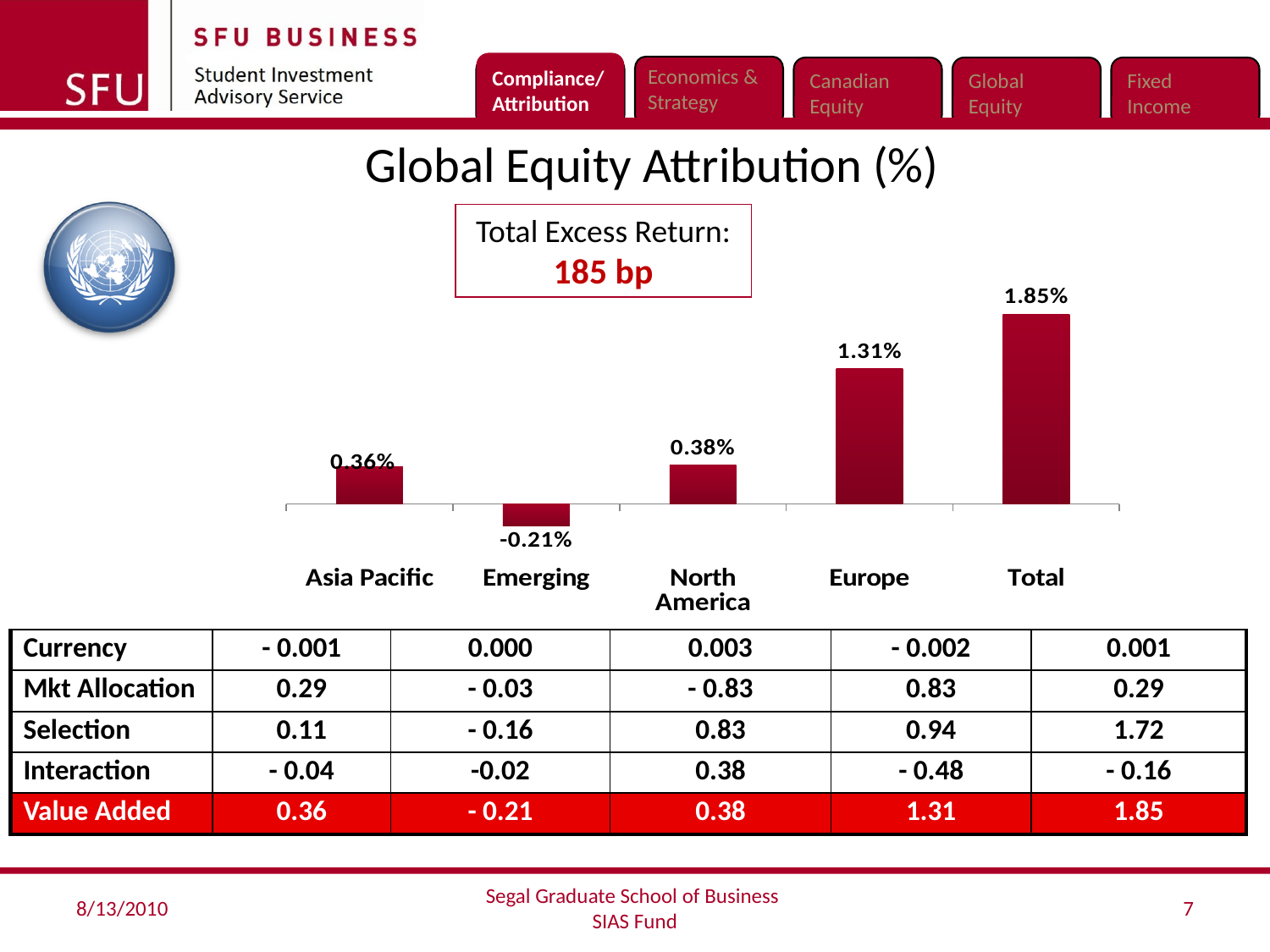
What kind of chart is the Global Equity Attribution chart? Bar chart What is the value for North America in the Global Equity Attribution chart? 0.38% Which is larger in the Global Equity Attribution chart, the value for Europe or the value for North America? Europe What is the title of the chart on the slide? Global Equity Attribution (%) What is the value for Asia Pacific in the Global Equity Attribution chart? 0.36% Which category in the Global Equity Attribution chart has a negative value? Emerging Which category has the highest value in the Global Equity Attribution chart? Total What is the value for Europe in the Global Equity Attribution chart? 1.31% What is the value for Emerging in the Global Equity Attribution chart? -0.21% Which category has the lowest value in the Global Equity Attribution chart? Emerging What is the difference between the values for Total and Europe in the Global Equity Attribution chart? 0.54% How many categories are shown on the x axis of the Global Equity Attribution chart? 5